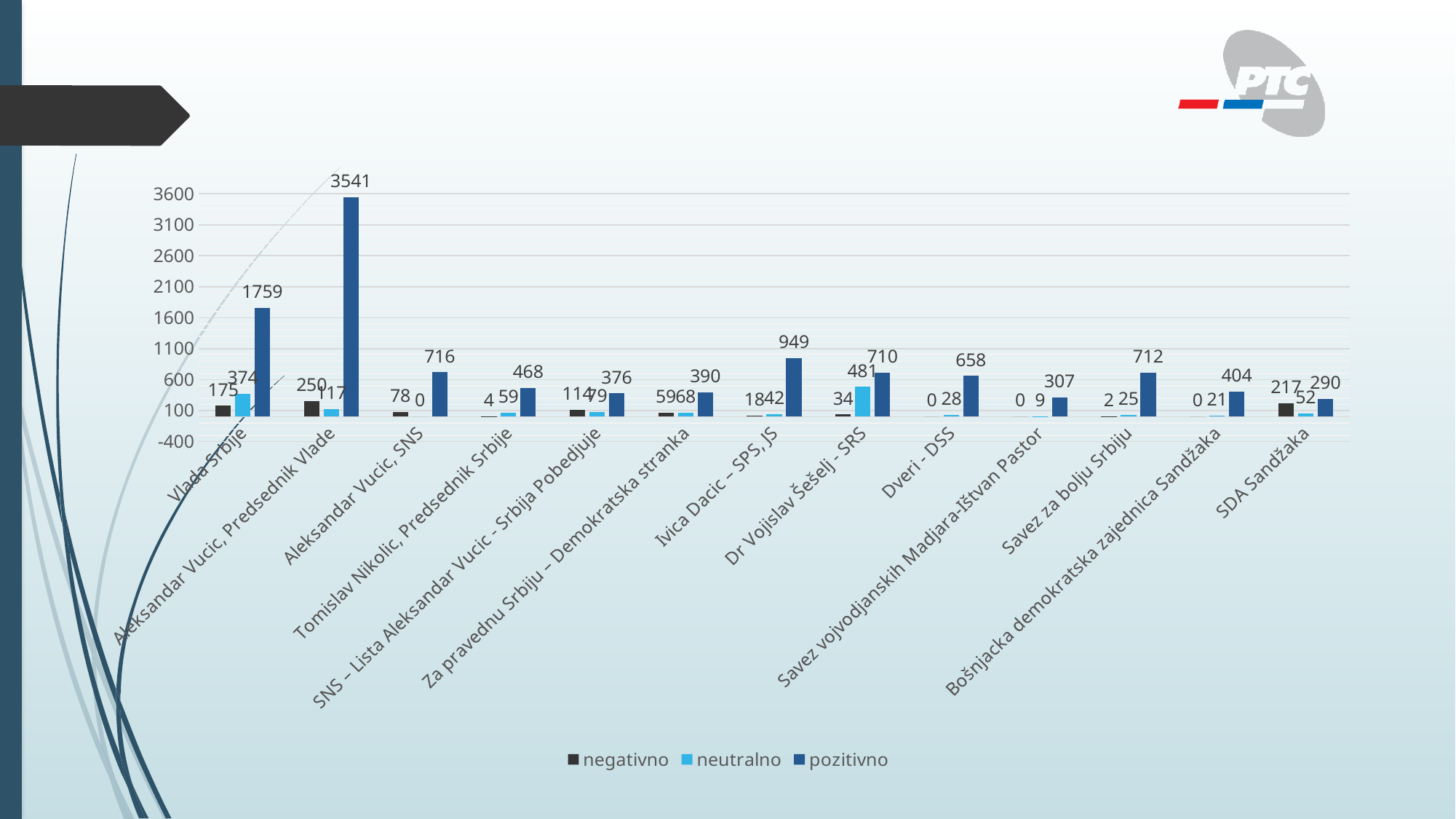
What is the total of the three values for Dveri - DSS? 686 What is the negativno value for SDA Sandžaka? 217 What is the pozitivno value for Aleksandar Vucic, Predsednik Vlade? 3541 Which is larger, the pozitivno value for Dveri - DSS or for Savez za bolju Srbiju? Savez za bolju Srbiju Which category has the lowest pozitivno value? SDA Sandžaka What is the difference between the pozitivno values for Vlada Srbije and Ivica Dacic – SPS, JS? 810 What is the neutralno value for Vlada Srbije? 374 What is the neutralno value for Dr Vojislav Šešelj - SRS? 481 What type of chart is shown on the slide? bar chart Which category has the highest pozitivno value? Aleksandar Vucic, Predsednik Vlade How many series does the legend list? 3 How many categories are shown on the x axis? 13